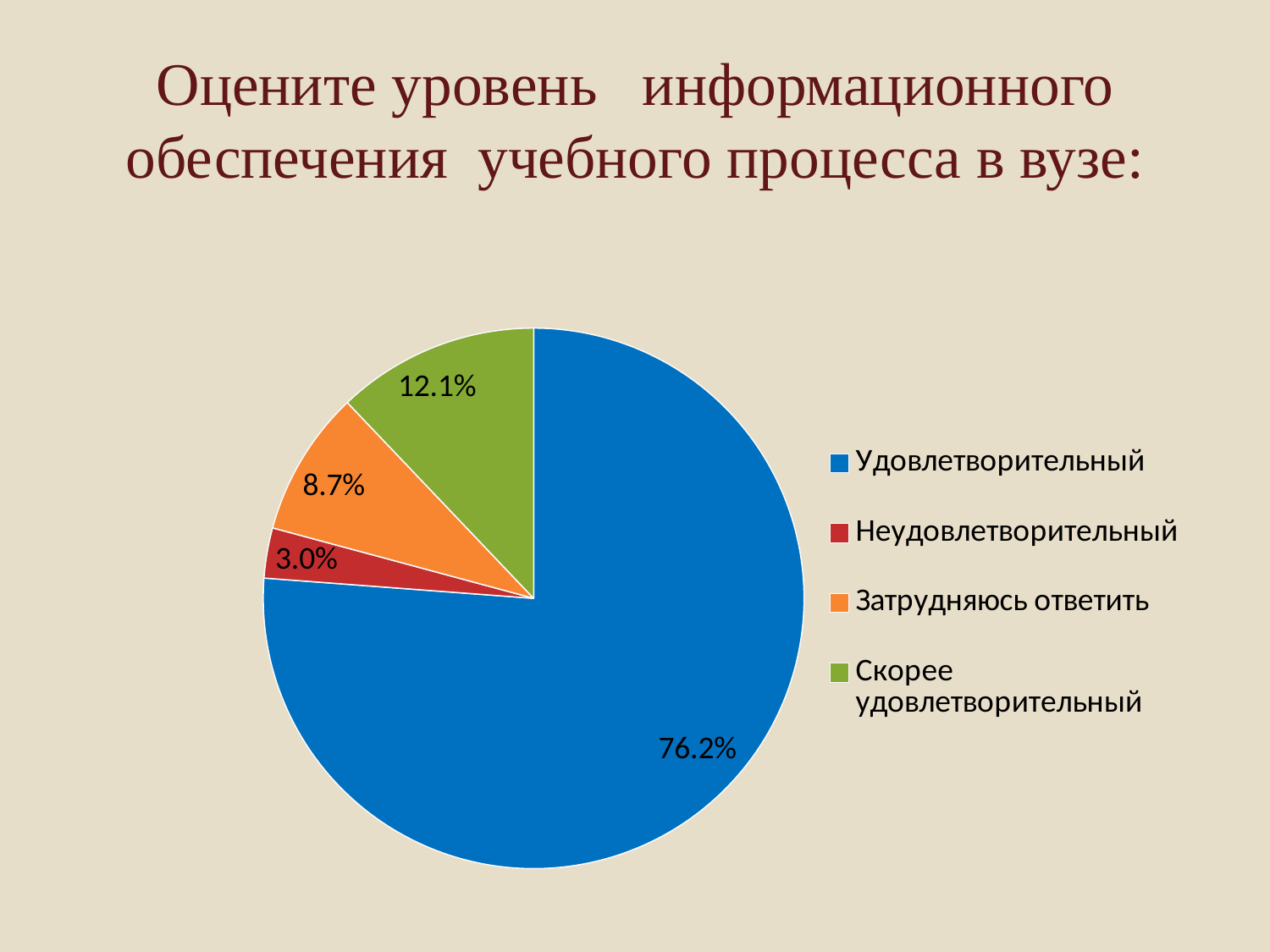
What percentage of respondents answered "Неудовлетворительный"? 3.0% Which category has the largest share of the pie? Удовлетворительный What is the difference in percentage points between "Скорее удовлетворительный" and "Затрудняюсь ответить"? 3.4 What is the combined share of "Удовлетворительный" and "Скорее удовлетворительный"? 88.3% What type of chart is shown on the slide? pie chart What colour is the slice for "Скорее удовлетворительный"? green What percentage of respondents answered "Удовлетворительный"? 76.2% Which is larger: the share for "Затрудняюсь ответить" or the share for "Неудовлетворительный"? Затрудняюсь ответить Which category has the smallest share of the pie? Неудовлетворительный What percentage of respondents answered "Затрудняюсь ответить"? 8.7% What percentage of respondents answered "Скорее удовлетворительный"? 12.1% How many categories does the pie chart have? 4